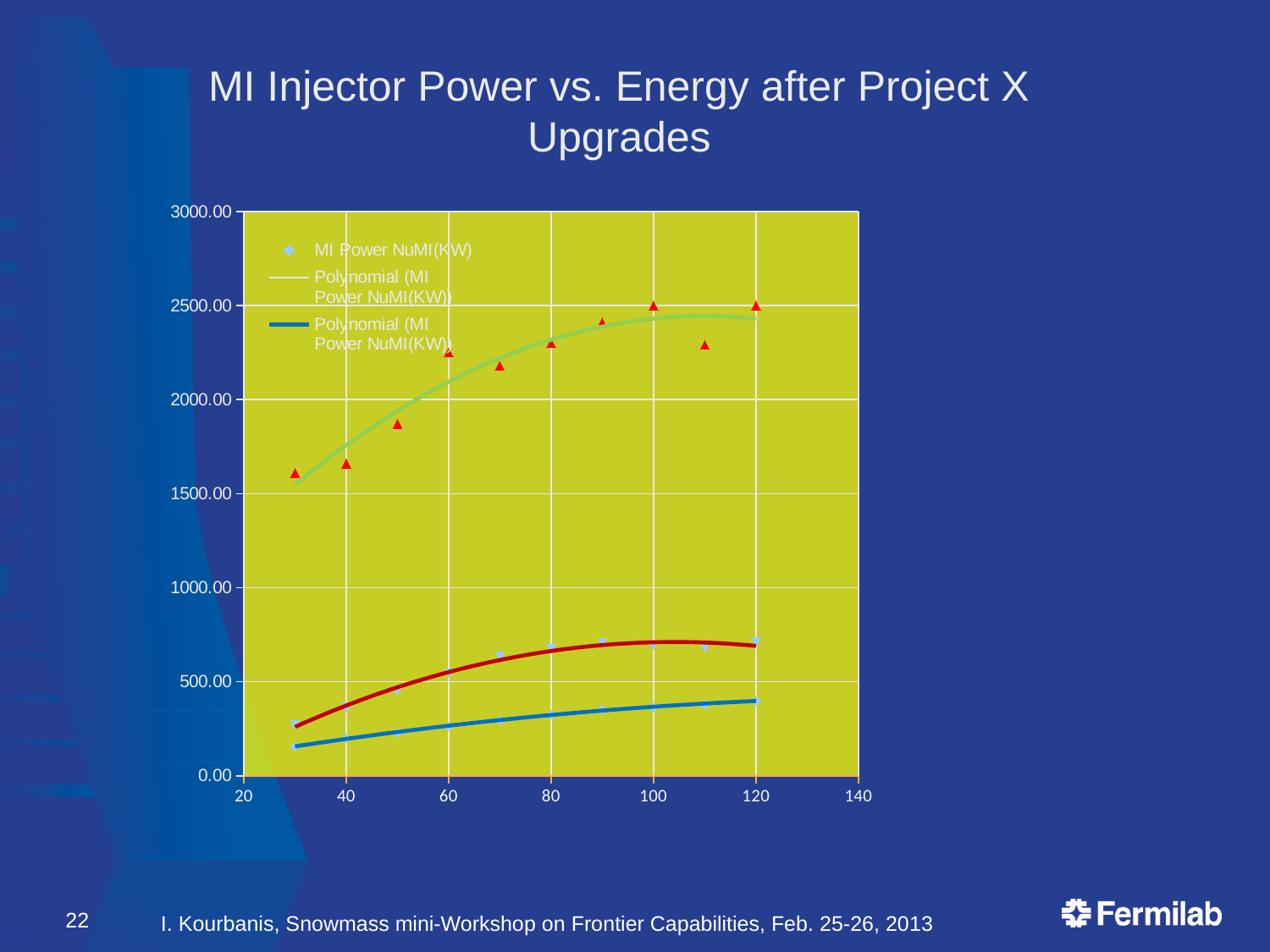
At which x value is the red triangle series at its lowest? 30 How many entries does the chart legend list? 3 What is the first entry in the chart legend? MI Power NuMI(KW) What kind of chart is shown on the slide? scatter chart Is the value of the red triangle point at x = 50 greater or less than 2000? less Is the value of the red triangle point at x = 60 greater or less than 2000? greater Is the value of the red triangle point at x = 110 greater or less than 2500? less Do the red triangle values generally rise or fall as x increases from 30 to 100? rise What is the title of the chart on the slide? MI Injector Power vs. Energy after Project X Upgrades